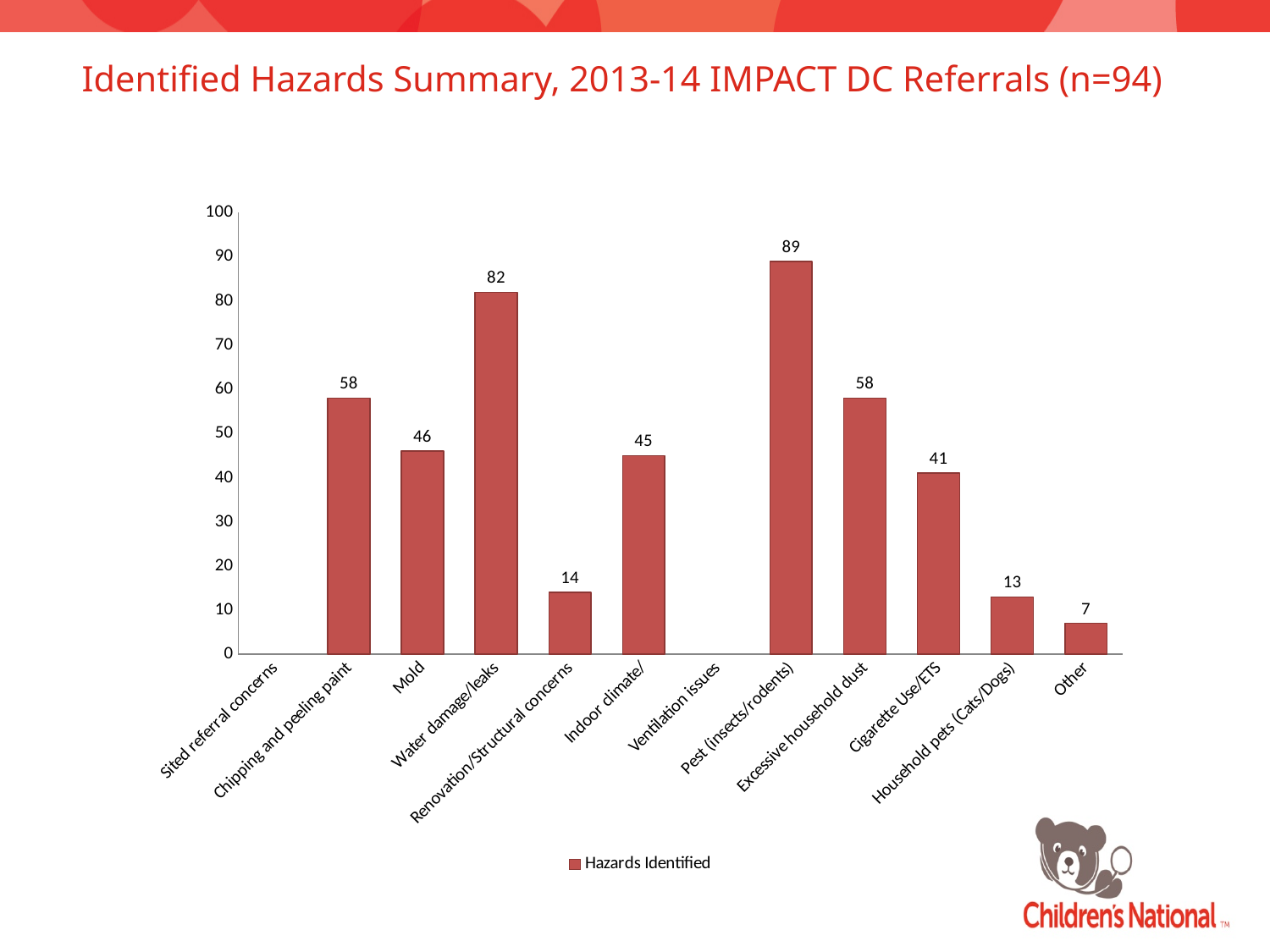
What is the value for Cigarette Use/ETS? 41 Which category has the highest value? Pest (insects/rodents) How many series does the legend list? 1 Which is larger, the value for Mold or the value for Cigarette Use/ETS? Mold How many categories are labelled on the x axis? 12 What is the value for Water damage/leaks? 82 What is the value for Household pets (Cats/Dogs)? 13 What is the difference between the values for Pest (insects/rodents) and Water damage/leaks? 7 Is the value for Renovation/Structural concerns greater or less than 20? less What kind of chart is shown on the slide? bar chart What is the value for Pest (insects/rodents)? 89 What is the difference between the values for Chipping and peeling paint and Mold? 12